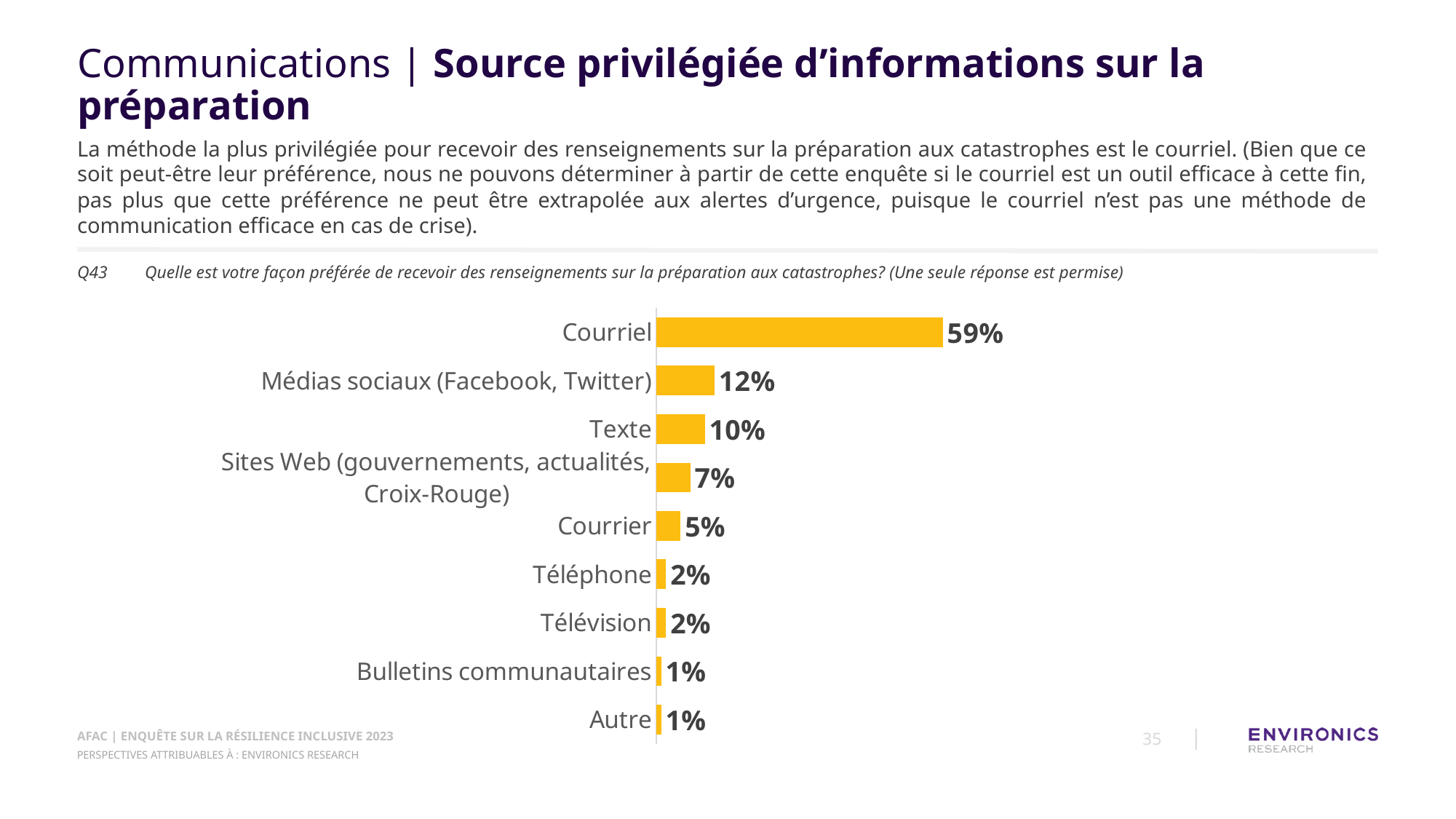
What is the value for Téléphone? 2% What is the value for Sites Web (gouvernements, actualités, Croix-Rouge)? 7% What is the difference between the values for Texte and Courrier? 5% Which category has the highest value? Courriel What is the value for Courrier? 5% What is the difference between the values for Courriel and Médias sociaux (Facebook, Twitter)? 47% What colour are the bars in the chart? Yellow Which is larger, the value for Texte or the value for Sites Web (gouvernements, actualités, Croix-Rouge)? Texte What kind of chart is shown on the slide? Bar chart How many categories are shown in the chart? 9 What is the value for Courriel? 59% What is the value for Médias sociaux (Facebook, Twitter)? 12%